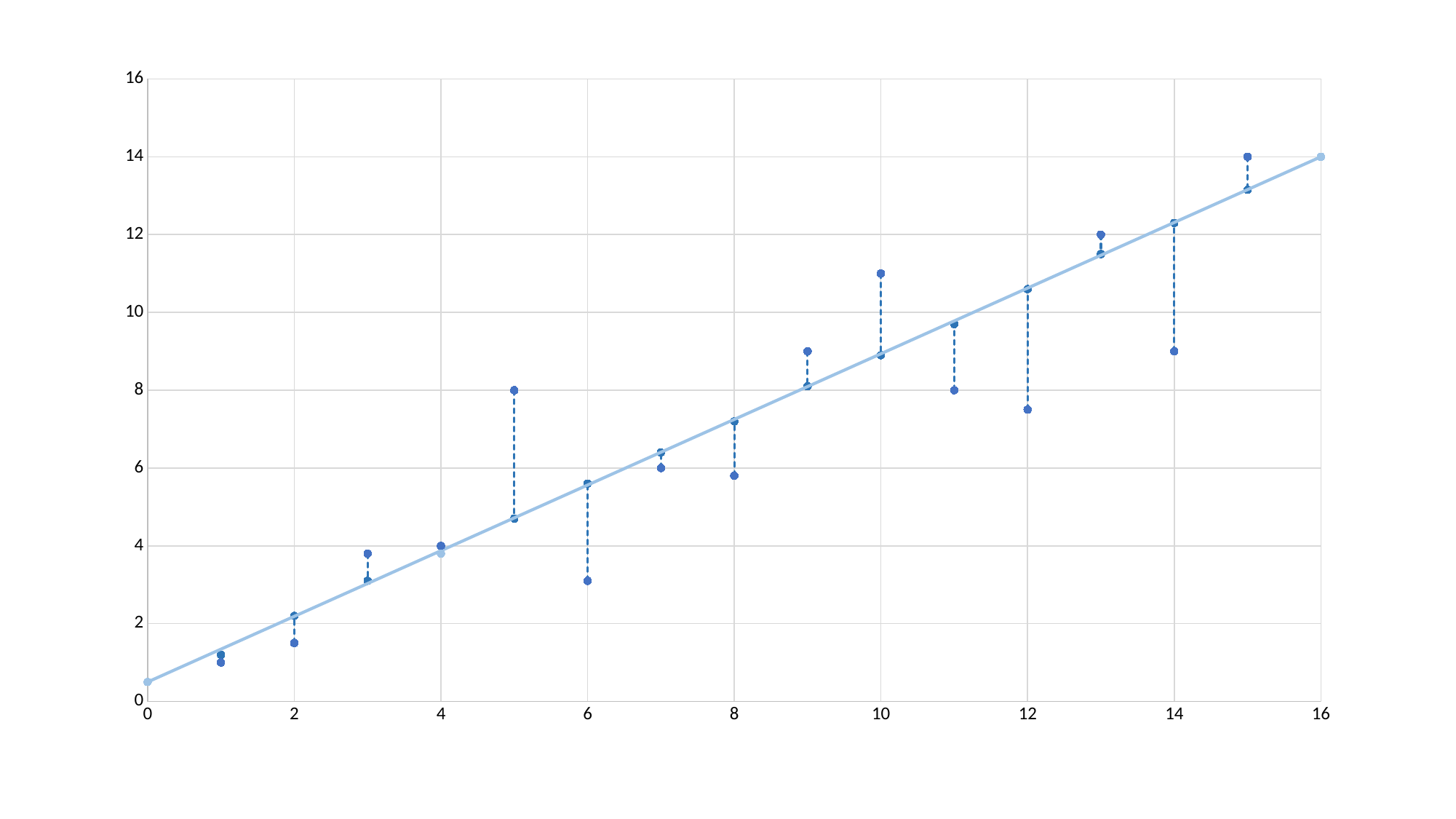
What is the y value of the dark scatter point at x = 15? 14 Do the plotted values generally rise or fall as x increases from 0 to 16? rise What kind of chart is shown on the slide? scatter chart What is the difference between the y values of the dark scatter points at x = 15 and x = 5? 6 Is the y value of the dark scatter point at x = 12 greater or less than 8? less How many dark scatter points are plotted on the chart? 15 At which x value is the lowest dark scatter point? 1 At which x value is the highest dark scatter point? 15 Which has the larger y value: the dark scatter point at x = 10 or the one at x = 14? x = 10 Is the y value of the dark scatter point at x = 10 greater or less than 10? greater What is the y value of the dark scatter point at x = 7? 6 What is the y value of the dark scatter point at x = 5? 8